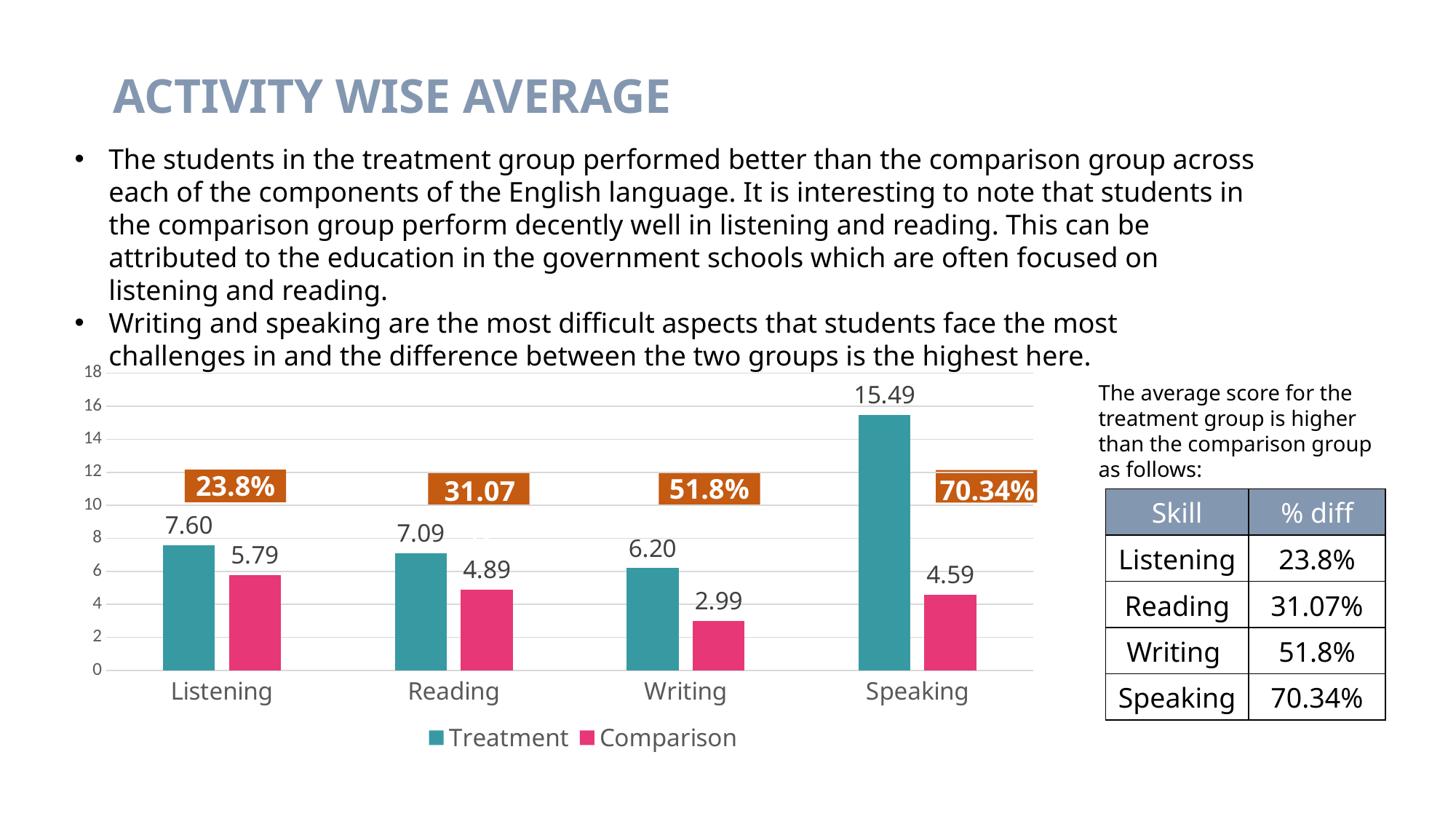
What kind of chart is shown on the slide? Bar chart What is the difference between the Treatment and Comparison values for Speaking? 10.90 What is the Comparison value for Writing? 2.99 What is the Treatment value for Speaking? 15.49 What is the Treatment value for Listening? 7.60 How many series does the legend list? 2 Which category has the lowest Comparison value? Writing How many categories are shown on the x axis? 4 What percentage difference label is shown above the Writing bars? 51.8% Which is larger, the Treatment value for Reading or the Comparison value for Listening? Treatment value for Reading Which category has the highest Treatment value? Speaking What is the Comparison value for Reading? 4.89